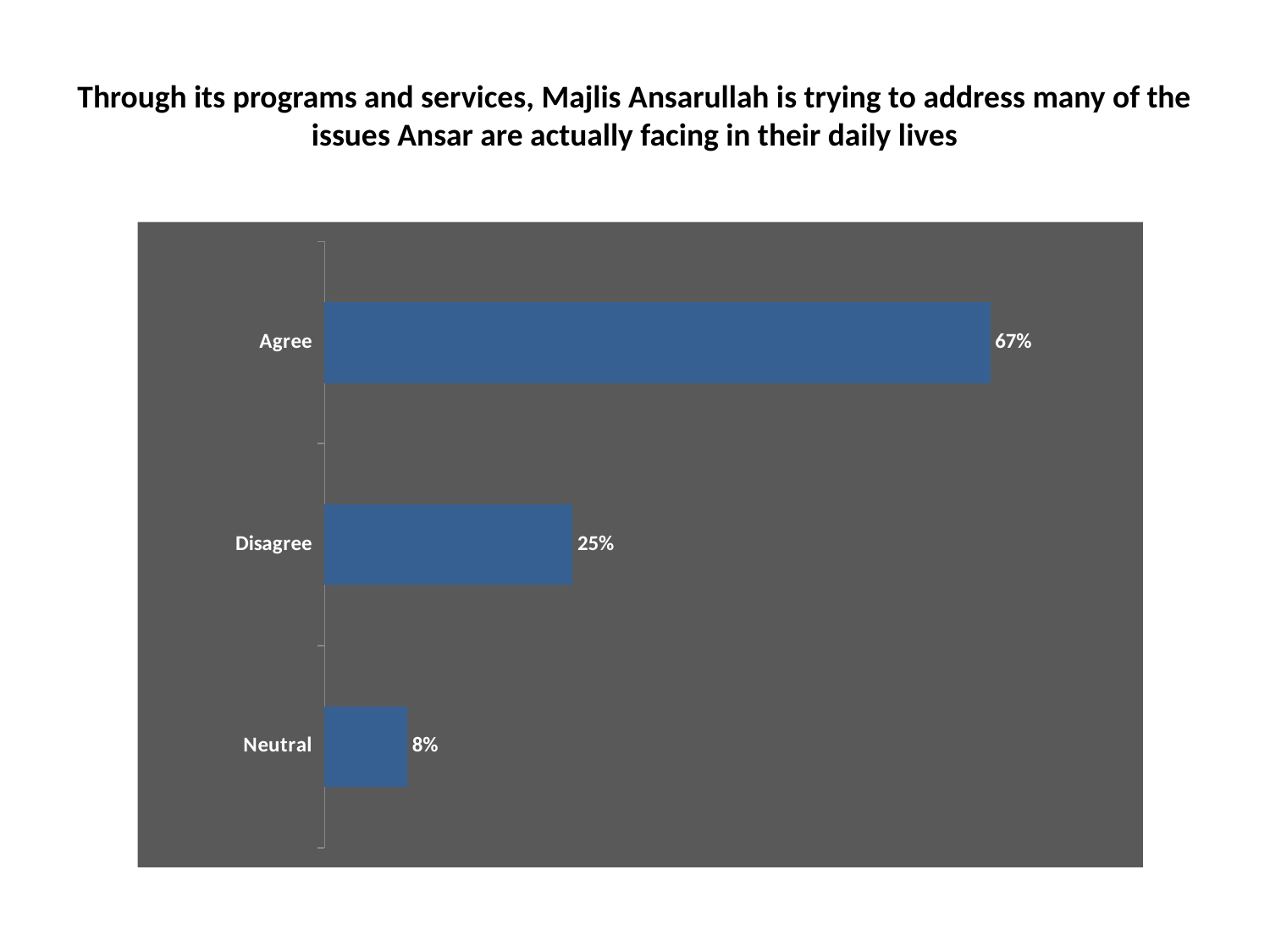
Which is larger, the value for Disagree or the value for Neutral? Disagree Which response category has the highest percentage? Agree What is the difference in percentage points between Disagree and Neutral? 17 Which response category has the lowest percentage? Neutral What kind of chart is shown on the slide? Bar chart What colour are the bars in the chart? Blue What is the difference in percentage points between Agree and Disagree? 42 How many response categories are shown in the chart? 3 What percentage of respondents chose Disagree? 25% What percentage of respondents chose Agree? 67% What percentage of respondents chose Neutral? 8% What is the combined percentage of Agree, Disagree and Neutral? 100%